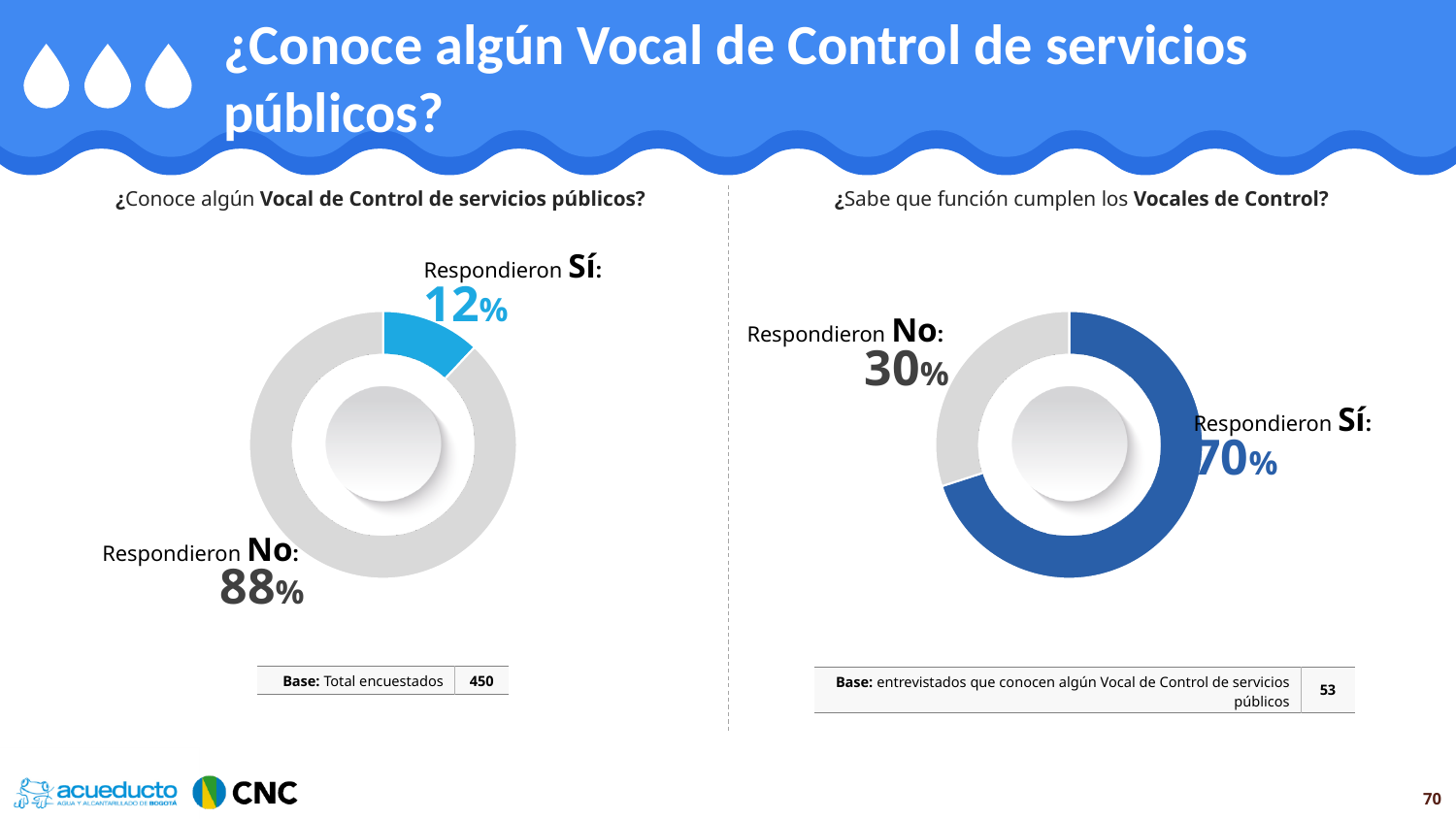
In the left chart (¿Conoce algún Vocal de Control de servicios públicos?), what is the difference in percentage points between the No and Sí responses? 76 In the left chart (¿Conoce algún Vocal de Control de servicios públicos?), what percentage of respondents answered Sí? 12% In the right chart (¿Sabe que función cumplen los Vocales de Control?), which response has the smaller share? No What type of chart is used on the left side of the slide? Donut (pie) chart In the right chart (¿Sabe que función cumplen los Vocales de Control?), what is the difference in percentage points between the Sí and No responses? 40 Is the Sí share in the right chart (¿Sabe que función cumplen los Vocales de Control?) larger or smaller than the Sí share in the left chart (¿Conoce algún Vocal de Control de servicios públicos?)? larger In the right chart (¿Sabe que función cumplen los Vocales de Control?), what percentage of respondents answered Sí? 70% In the left chart (¿Conoce algún Vocal de Control de servicios públicos?), what percentage of respondents answered No? 88% In the left chart (¿Conoce algún Vocal de Control de servicios públicos?), which response has the larger share? No What is the base (number of respondents) shown for the left chart (¿Conoce algún Vocal de Control de servicios públicos?)? 450 How many response categories are shown in the right chart (¿Sabe que función cumplen los Vocales de Control?)? 2 In the right chart (¿Sabe que función cumplen los Vocales de Control?), what percentage of respondents answered No? 30%